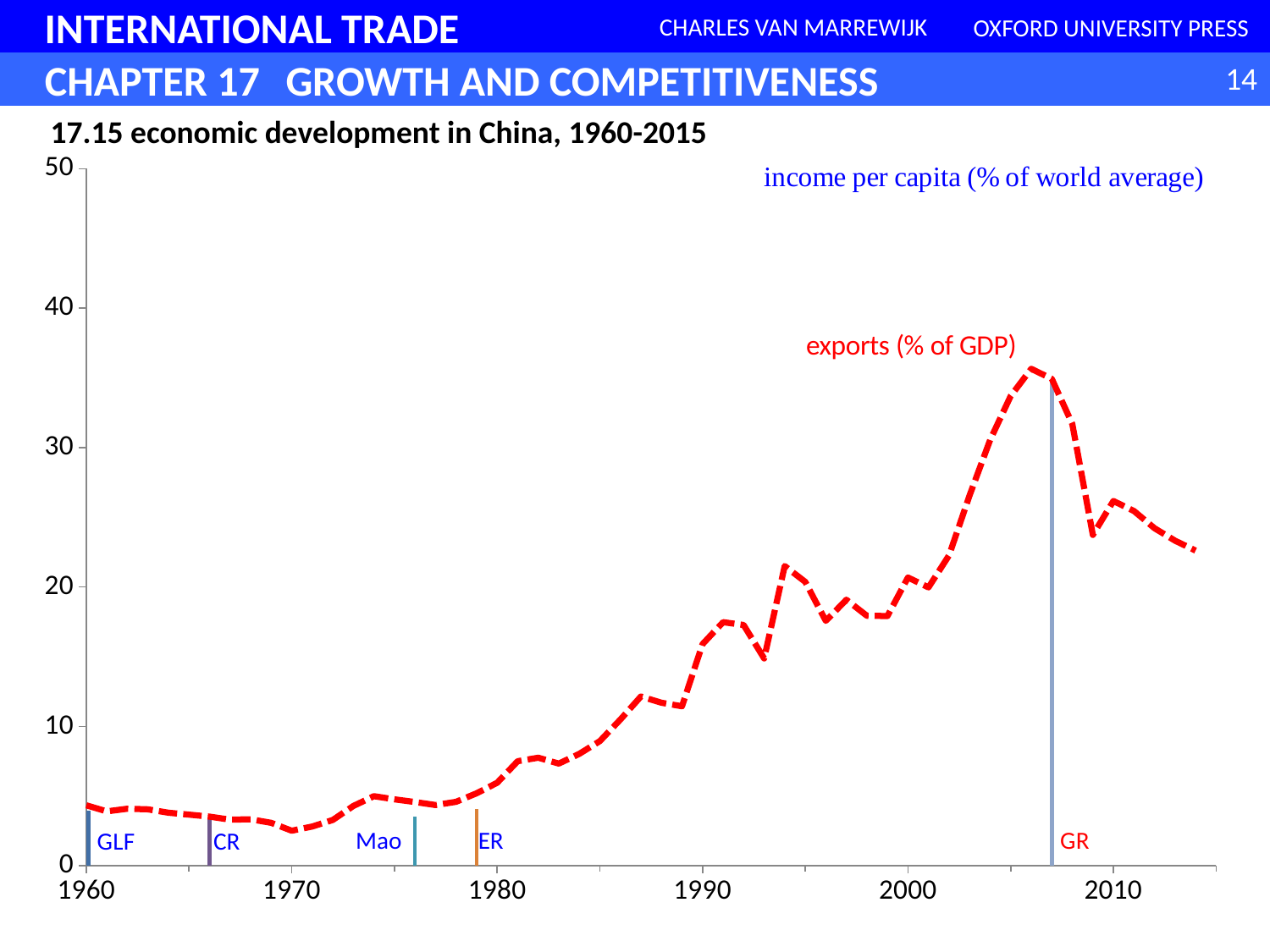
Is the value of exports (% of GDP) at the end of the series (around 2014) greater or less than 20? greater Is the value of exports (% of GDP) in 1960 greater or less than 10? less What does the red dashed line represent? exports (% of GDP) Is the peak value of exports (% of GDP) around 2006 greater or less than 30? greater What is the title of the chart? 17.15 economic development in China, 1960-2015 Does the exports (% of GDP) line rise or fall after the GR marker in 2007? fall In which decade does the exports (% of GDP) line reach its highest point? 2000s How many labelled vertical event markers (GLF, CR, Mao, ER, GR) are shown on the chart? 5 What kind of chart is shown on the slide? line chart Does the exports (% of GDP) line generally rise or fall between 1980 and 2007? rise